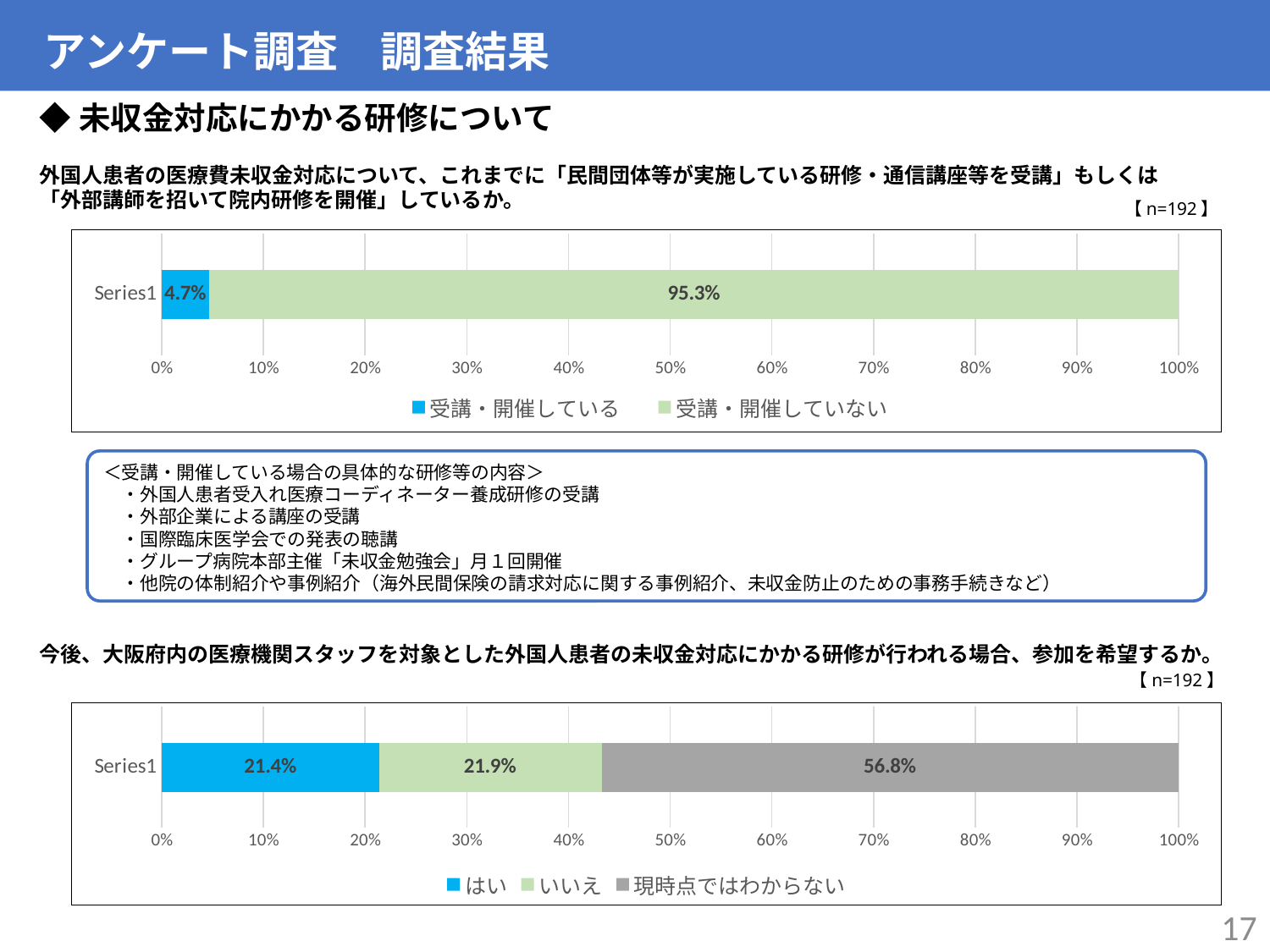
In the bottom chart, is the value for 現時点ではわからない greater or less than 50%? greater In the bottom chart, what is the value for 現時点ではわからない? 56.8% In the bottom chart, what is the value for いいえ? 21.9% In the bottom chart, which series has the highest value? 現時点ではわからない In the bottom chart, how many series does the legend list? 3 In the top chart, what is the value for 受講・開催していない? 95.3% What kind of chart is the top chart? Stacked bar chart In the top chart, how many series does the legend list? 2 In the bottom chart, what is the value for はい? 21.4% In the top chart, what is the value for 受講・開催している? 4.7% In the bottom chart, what is the difference between 現時点ではわからない and はい? 35.4% In the top chart, what is the difference between 受講・開催していない and 受講・開催している? 90.6%